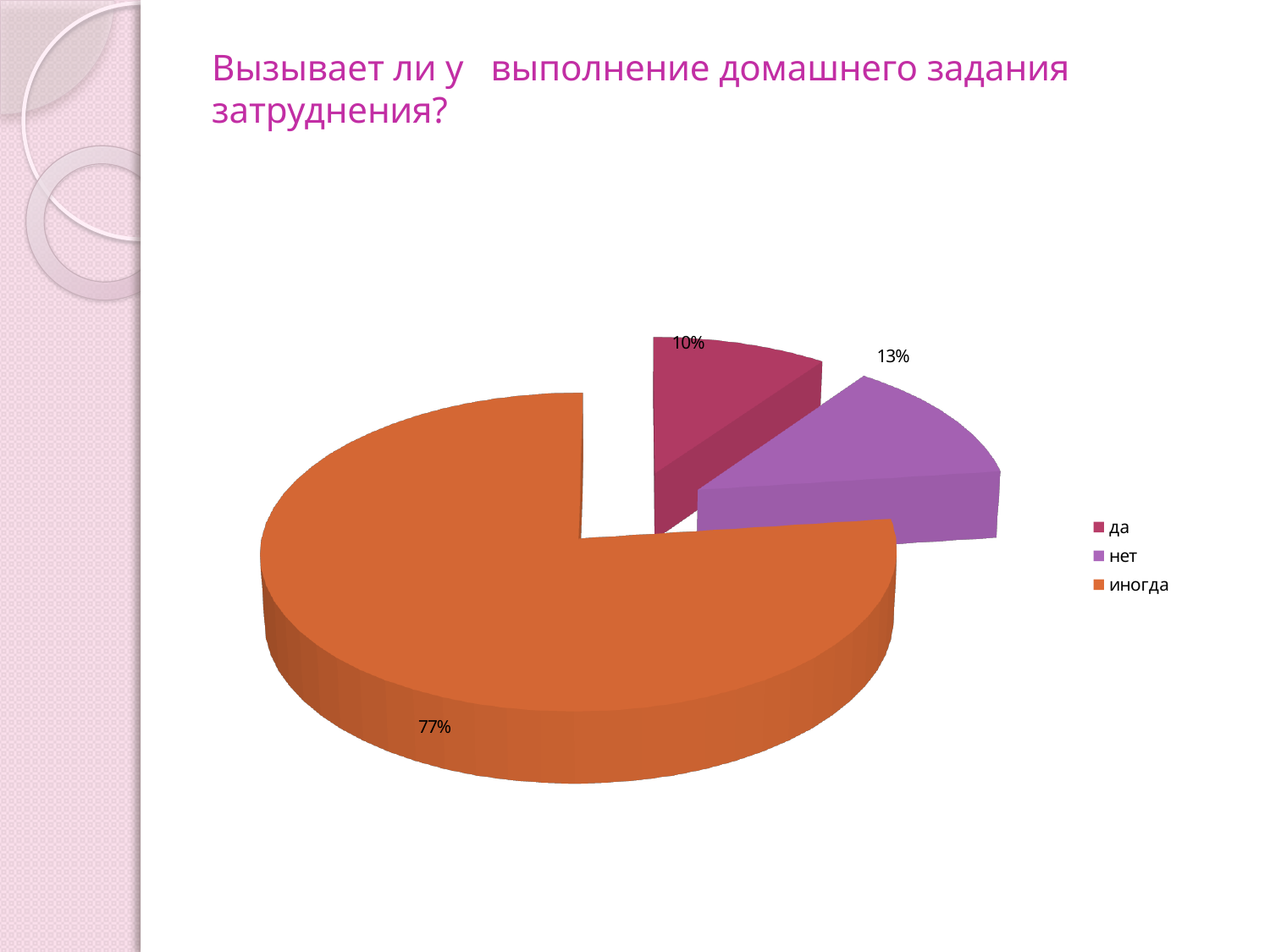
How many categories does the pie chart show? 3 Which category has the largest slice of the pie? иногда What kind of chart is shown on the slide? pie chart Which is larger, the "нет" slice or the "да" slice? нет What share of the pie does the "да" slice represent? 10% What is the difference in percentage points between the "иногда" slice and the "нет" slice? 64 What colour is the "иногда" slice? orange What are the three entries listed in the legend? да, нет, иногда Which category has the smallest slice of the pie? да What is the difference in percentage points between the "нет" slice and the "да" slice? 3 What share of the pie does the "нет" slice represent? 13% What share of the pie does the "иногда" slice represent? 77%